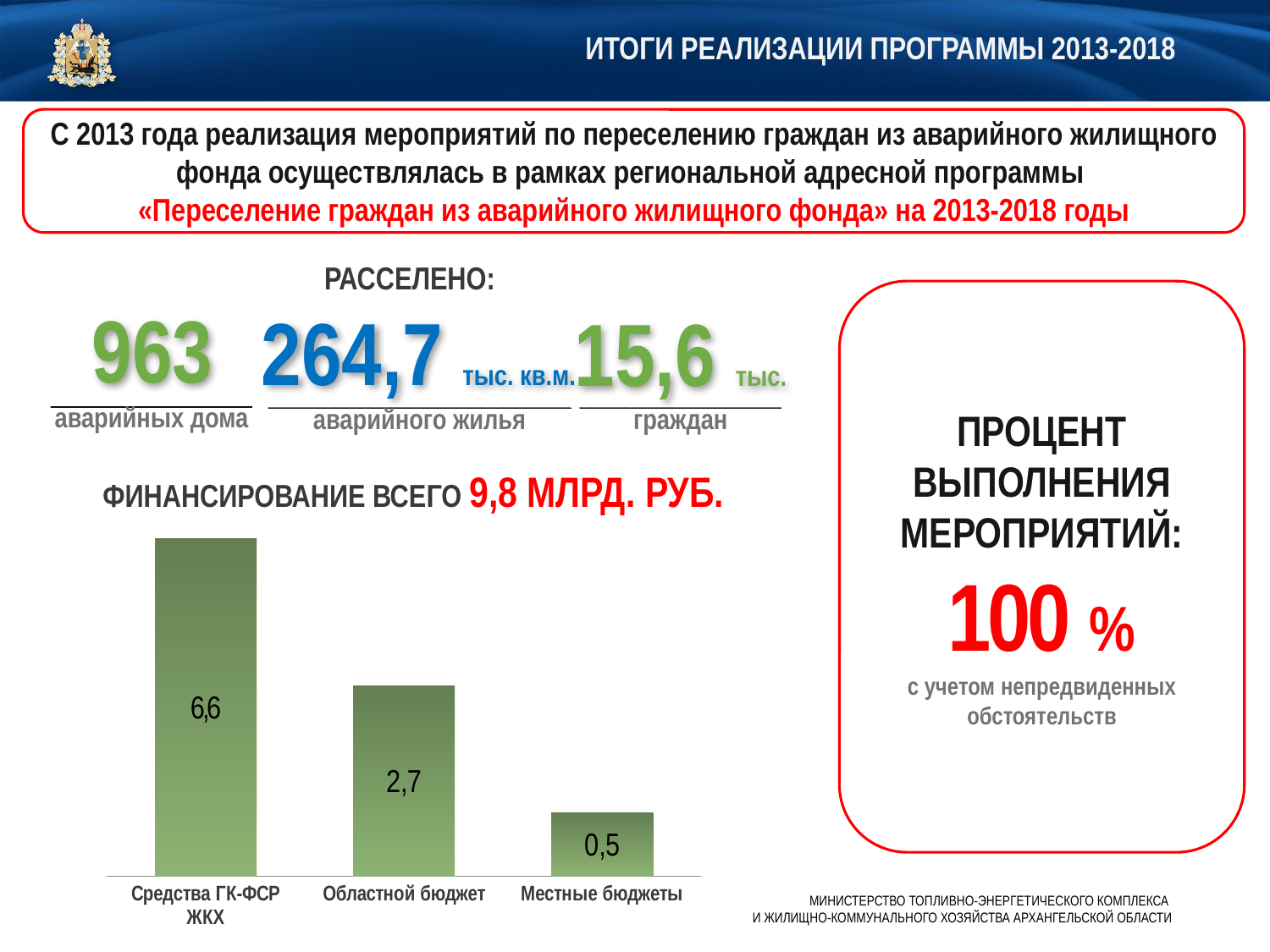
How many categories are shown in the bar chart? 3 What total funding amount is stated in the heading above the bar chart? 9,8 МЛРД. РУБ. What is the value for Местные бюджеты in the bar chart? 0,5 What is the difference between the values for Областной бюджет and Местные бюджеты? 2,2 What is the difference between the values for Средства ГК-ФСР ЖКХ and Областной бюджет? 3,9 Which category has the highest value in the bar chart? Средства ГК-ФСР ЖКХ What is the value for Областной бюджет in the bar chart? 2,7 Which is larger: the value for Областной бюджет or the value for Местные бюджеты? Областной бюджет What kind of chart is shown on the slide? Bar chart Which category has the lowest value in the bar chart? Местные бюджеты What is the value for Средства ГК-ФСР ЖКХ in the bar chart? 6,6 Do the values in the bar chart rise or fall from left to right? Fall